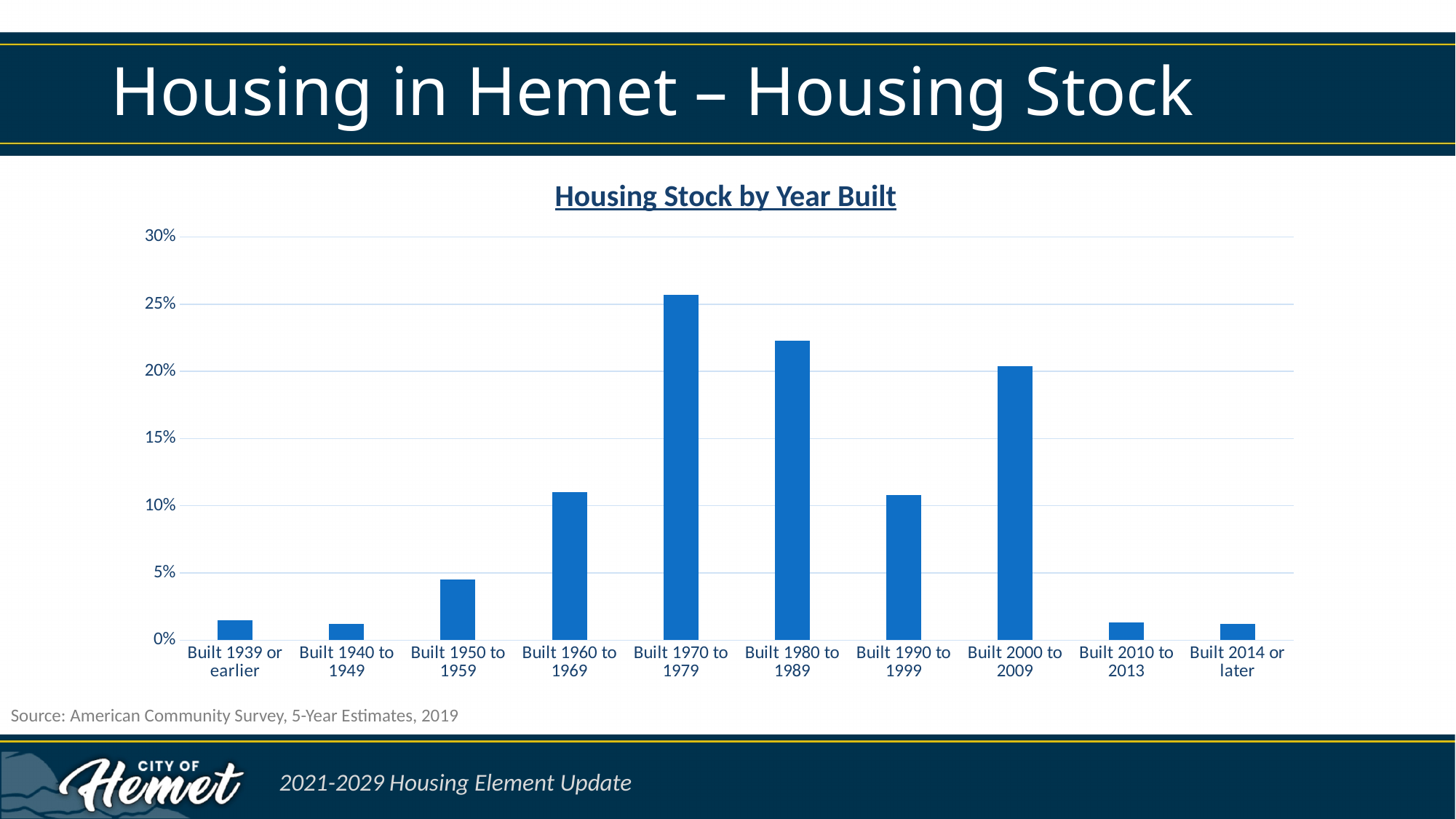
Is the value for Built 1970 to 1979 greater or less than 20%? greater Is the value for Built 1980 to 1989 greater or less than 20%? greater Is the value for Built 1960 to 1969 greater or less than 5%? greater What is the title of the chart? Housing Stock by Year Built Which year-built category has the highest share of housing stock? Built 1970 to 1979 How many year-built categories are shown on the x axis? 10 What kind of chart is shown on the slide? Bar chart Which is larger, the value for Built 1950 to 1959 or Built 1939 or earlier? Built 1950 to 1959 Which is larger, the value for Built 1980 to 1989 or Built 2000 to 2009? Built 1980 to 1989